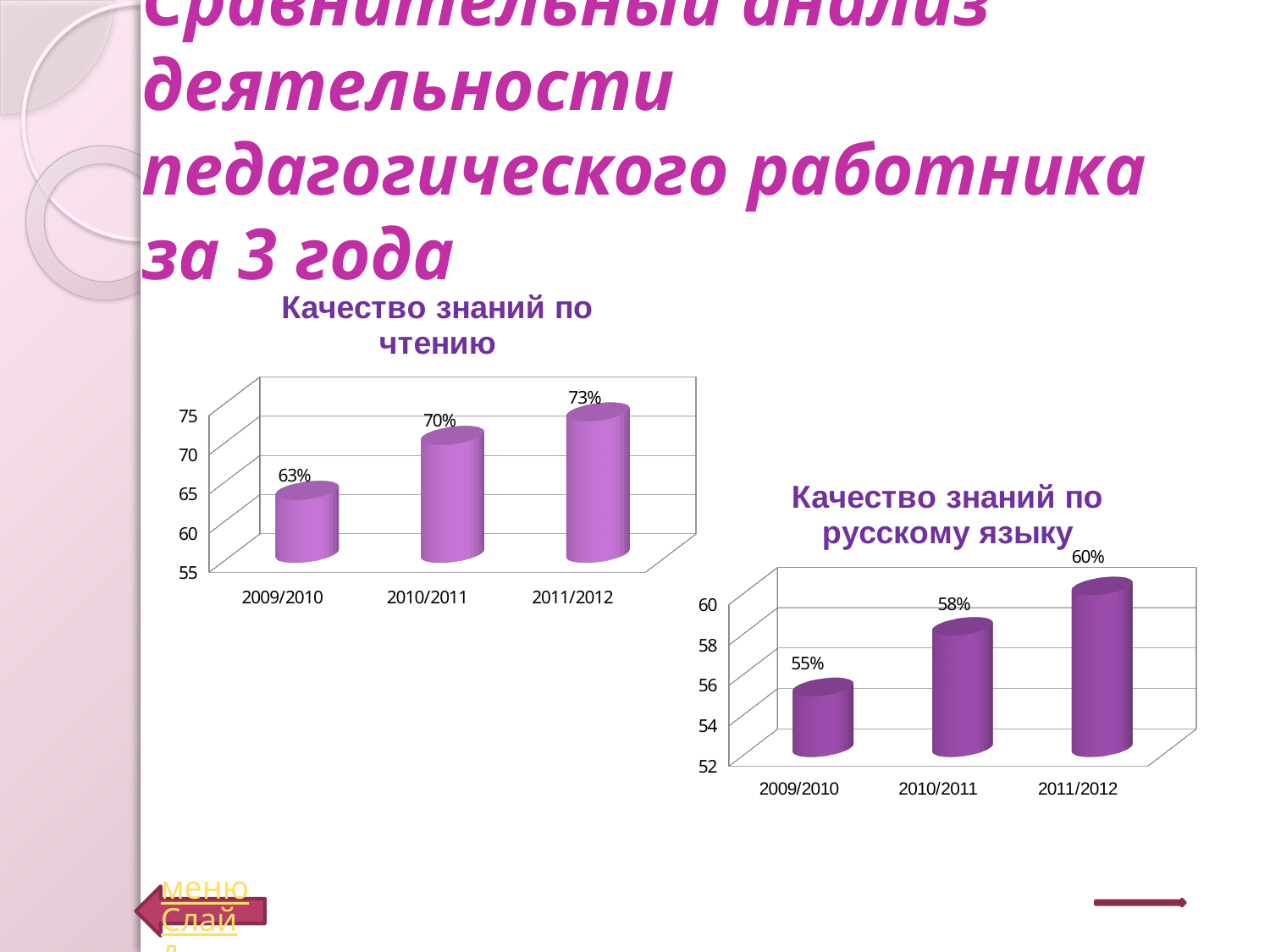
In the chart titled "Качество знаний по русскому языку", what is the difference between the values for 2010/2011 and 2009/2010? 3% In the chart titled "Качество знаний по чтению", what is the difference between the values for 2011/2012 and 2009/2010? 10% How many categories are shown in the chart titled "Качество знаний по русскому языку"? 3 In the chart titled "Качество знаний по русскому языку", do the values rise or fall from 2009/2010 to 2011/2012? Rise In the chart titled "Качество знаний по чтению", what is the value for 2009/2010? 63% In the chart titled "Качество знаний по чтению", which year has the highest value? 2011/2012 In the chart titled "Качество знаний по русскому языку", what is the value for 2011/2012? 60% In the chart titled "Качество знаний по чтению", what is the value for 2011/2012? 73% What kind of chart is the chart titled "Качество знаний по чтению"? Bar chart In the chart titled "Качество знаний по русскому языку", what is the value for 2010/2011? 58% In the chart titled "Качество знаний по русскому языку", which year has the lowest value? 2009/2010 In the chart titled "Качество знаний по чтению", which is larger: the value for 2010/2011 or 2009/2010? 2010/2011